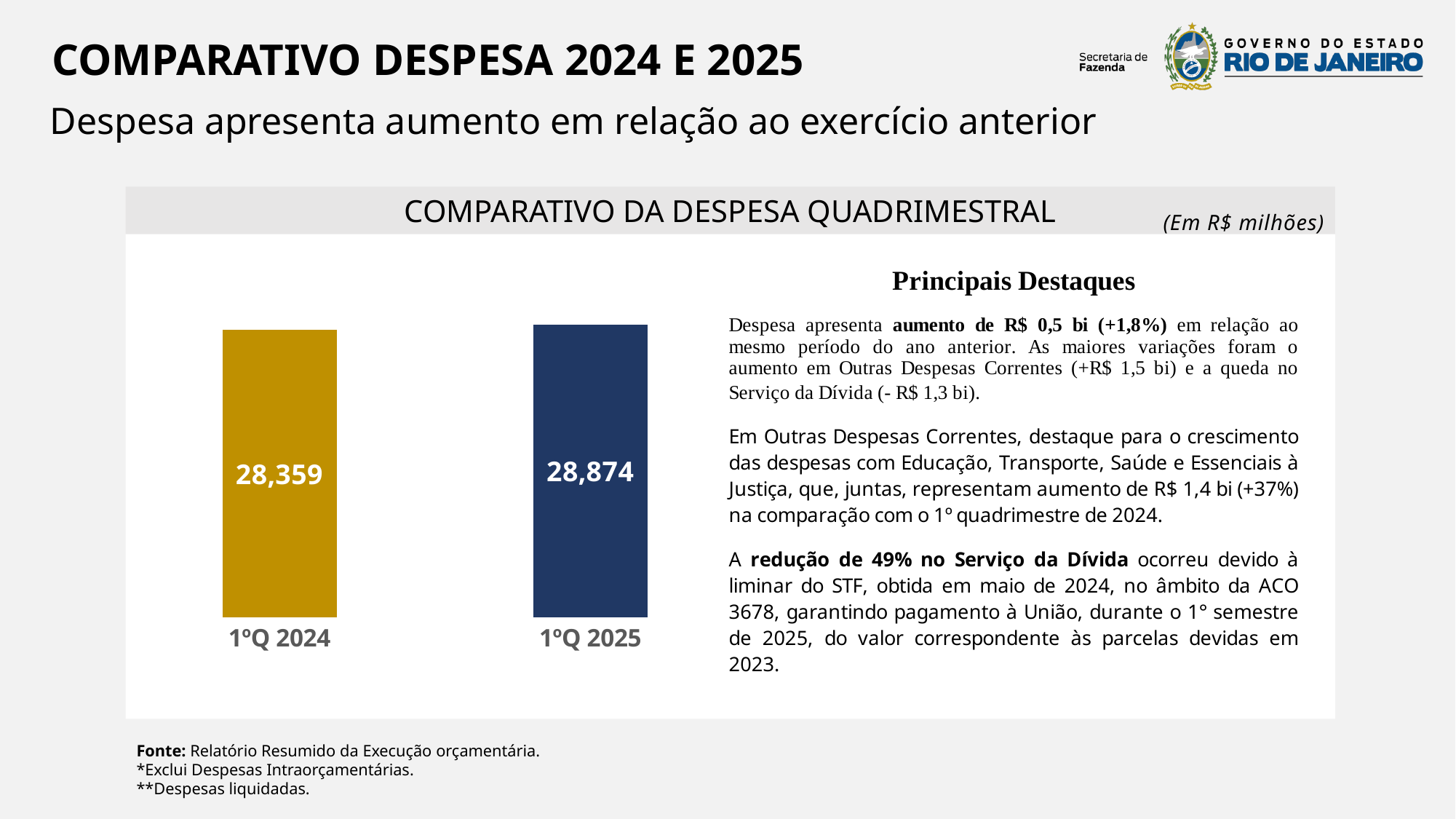
What is the difference between the values for 1ºQ 2025 and 1ºQ 2024? 515 What kind of chart is shown on the slide? bar chart In what unit are the chart values expressed? R$ milhões Which period has the lower value? 1ºQ 2024 How many bars are plotted in the chart? 2 What is the value for 1ºQ 2025? 28,874 Do the values rise or fall from 1ºQ 2024 to 1ºQ 2025? rise What is the title of the chart? COMPARATIVO DA DESPESA QUADRIMESTRAL What is the value for 1ºQ 2024? 28,359 Is the value for 1ºQ 2025 larger or smaller than the value for 1ºQ 2024? larger Which period has the higher value? 1ºQ 2025